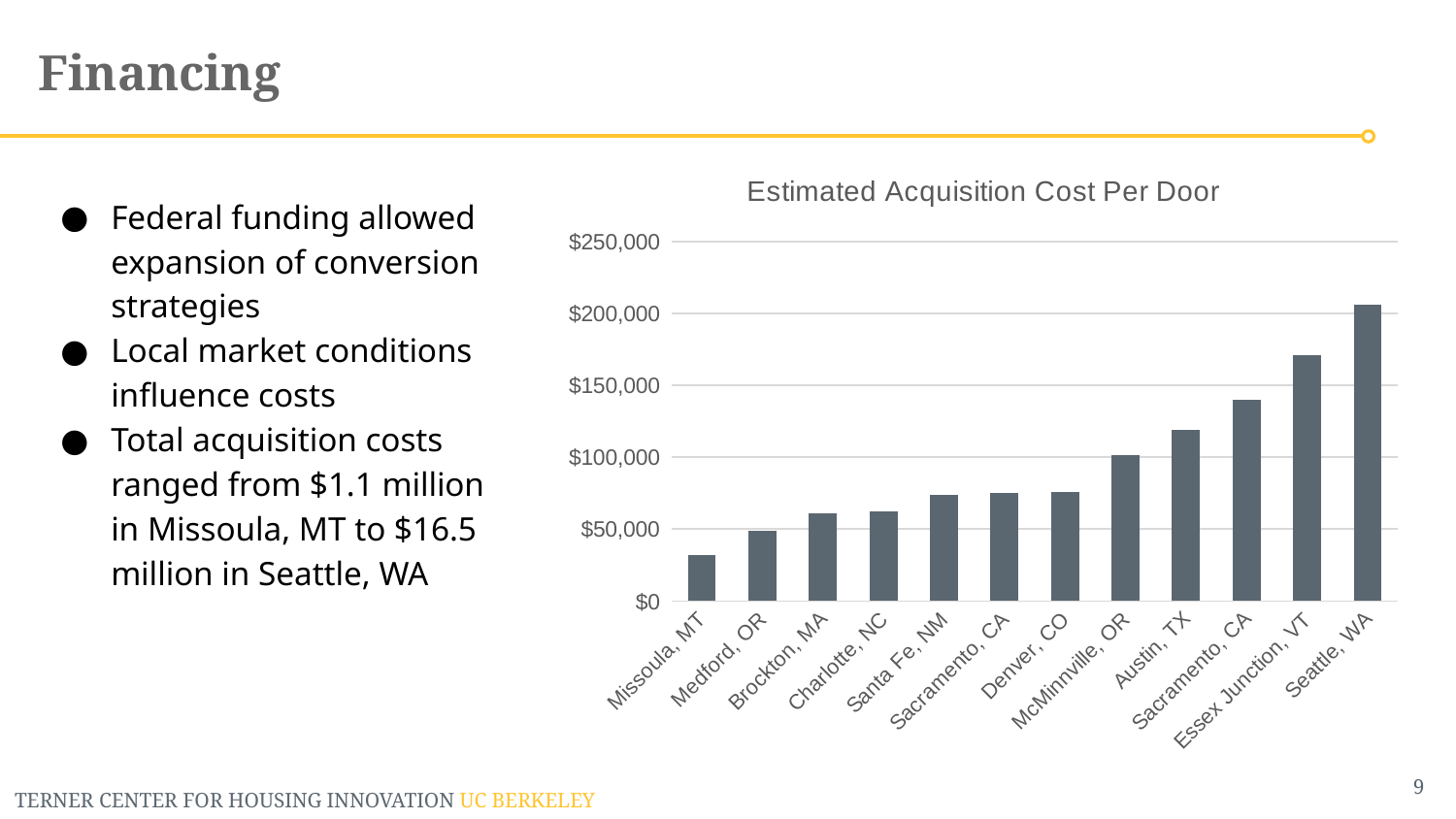
Which city has the highest estimated acquisition cost per door? Seattle, WA Which has a higher estimated acquisition cost per door, Essex Junction, VT or Austin, TX? Essex Junction, VT Is the value for Seattle, WA greater or less than $200,000? greater Which city has the lowest estimated acquisition cost per door? Missoula, MT What is the title of the chart? Estimated Acquisition Cost Per Door How many cities are shown on the x axis of the chart? 12 Is the value for Denver, CO greater or less than $100,000? less Is the value for Essex Junction, VT greater or less than $150,000? greater Which has a lower estimated acquisition cost per door, Medford, OR or Denver, CO? Medford, OR What kind of chart is shown on the slide? bar chart Do the values rise or fall moving from left to right along the x axis? rise